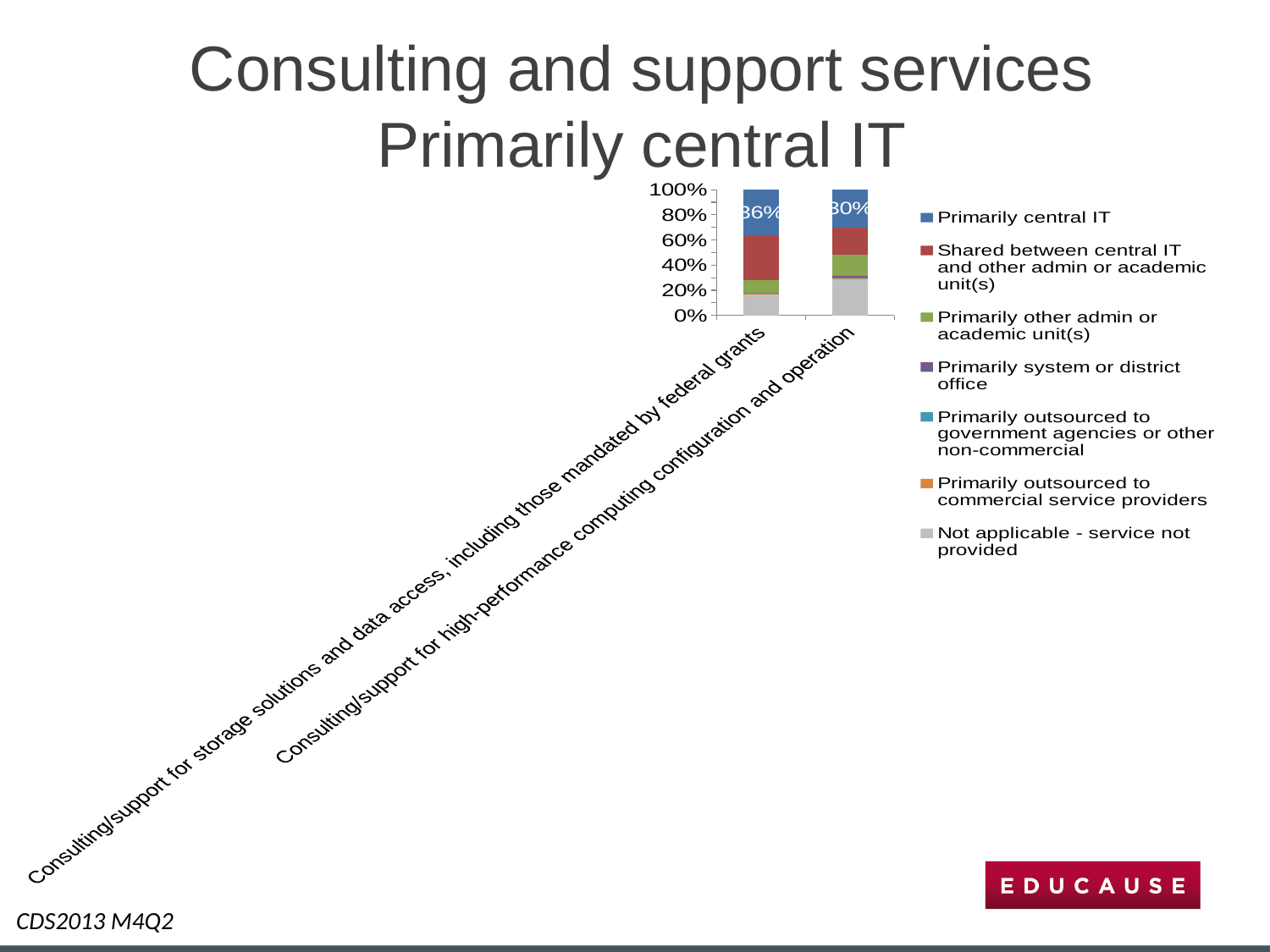
What is the 'Primarily central IT' value for 'Consulting/support for high-performance computing configuration and operation'? 30% Which category has the larger 'Not applicable - service not provided' segment? Consulting/support for high-performance computing configuration and operation Which category has the larger 'Primarily central IT' share: storage solutions and data access, or high-performance computing? Consulting/support for storage solutions and data access, including those mandated by federal grants What kind of chart is shown on the slide? Stacked bar chart How many categories are shown on the x axis of the chart? 2 What is the highest value shown on the chart's y axis? 100% What is the 'Primarily central IT' value for 'Consulting/support for storage solutions and data access, including those mandated by federal grants'? 36% How many series does the chart's legend list? 7 Is the 'Not applicable - service not provided' value for 'Consulting/support for storage solutions and data access' greater or less than 20%? less What is the difference in the 'Primarily central IT' share between the storage solutions category and the high-performance computing category? 6 percentage points Is the 'Not applicable - service not provided' value for 'Consulting/support for high-performance computing configuration and operation' greater or less than 20%? greater What is the first series listed in the chart's legend? Primarily central IT